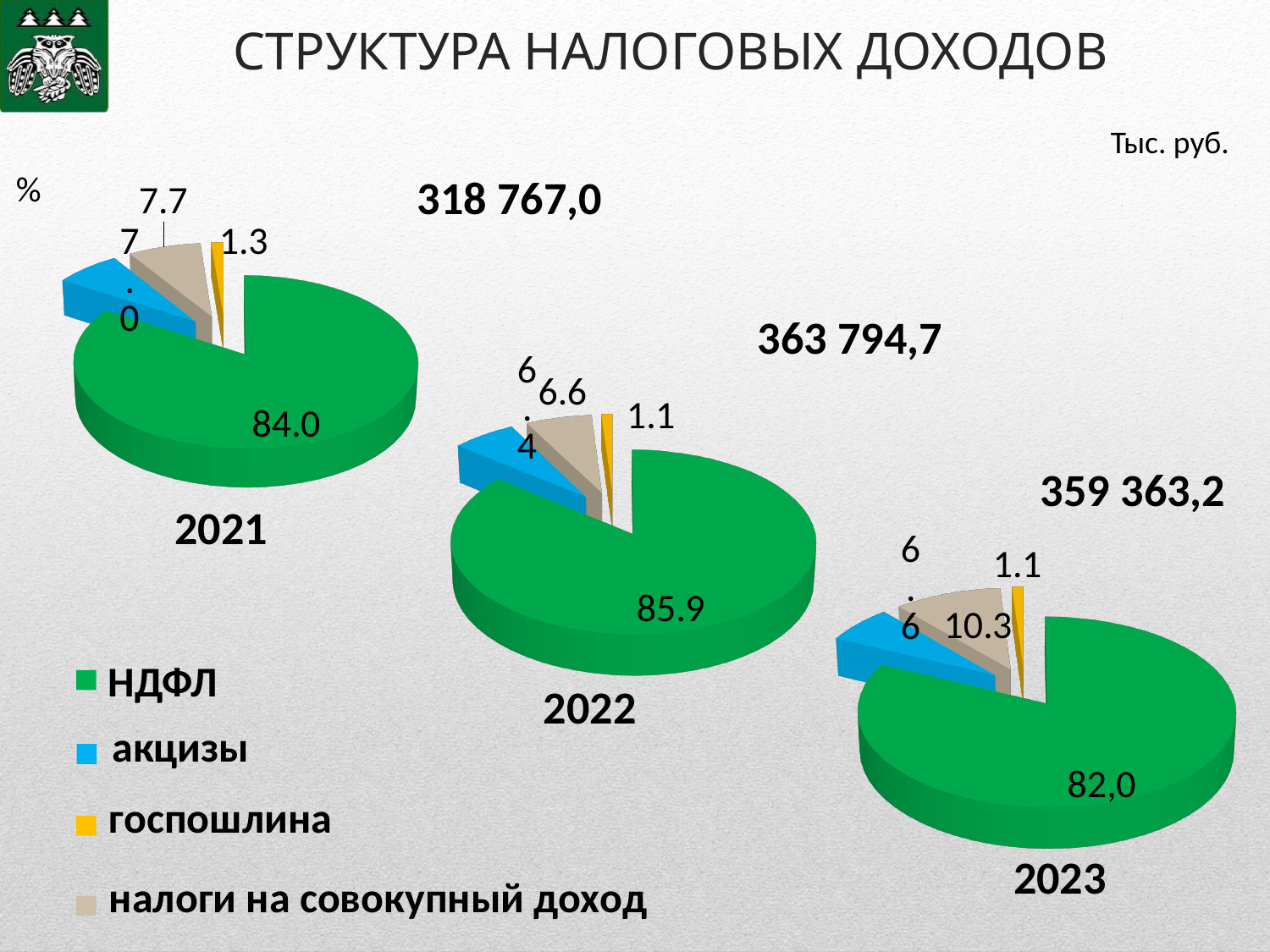
In the 2023 pie chart, what is the share of налоги на совокупный доход? 10.3 In the 2022 pie chart, which category has the smallest share? госпошлина What total amount (тыс. руб.) is shown next to the 2022 pie chart? 363 794,7 In the 2023 pie chart, which is larger: акцизы or налоги на совокупный доход? налоги на совокупный доход In the 2021 pie chart, what is the share of госпошлина? 1.3 How many categories does the legend list? 4 In the 2023 pie chart, which category has the largest share? НДФЛ In the 2022 pie chart, what is the share of НДФЛ? 85.9 Which colour represents акцизы in the pie charts? blue What kind of chart is used for the 2021 data? pie chart What is the difference between the НДФЛ share in 2022 and in 2023? 3.9 In the 2021 pie chart, what is the share of НДФЛ? 84.0